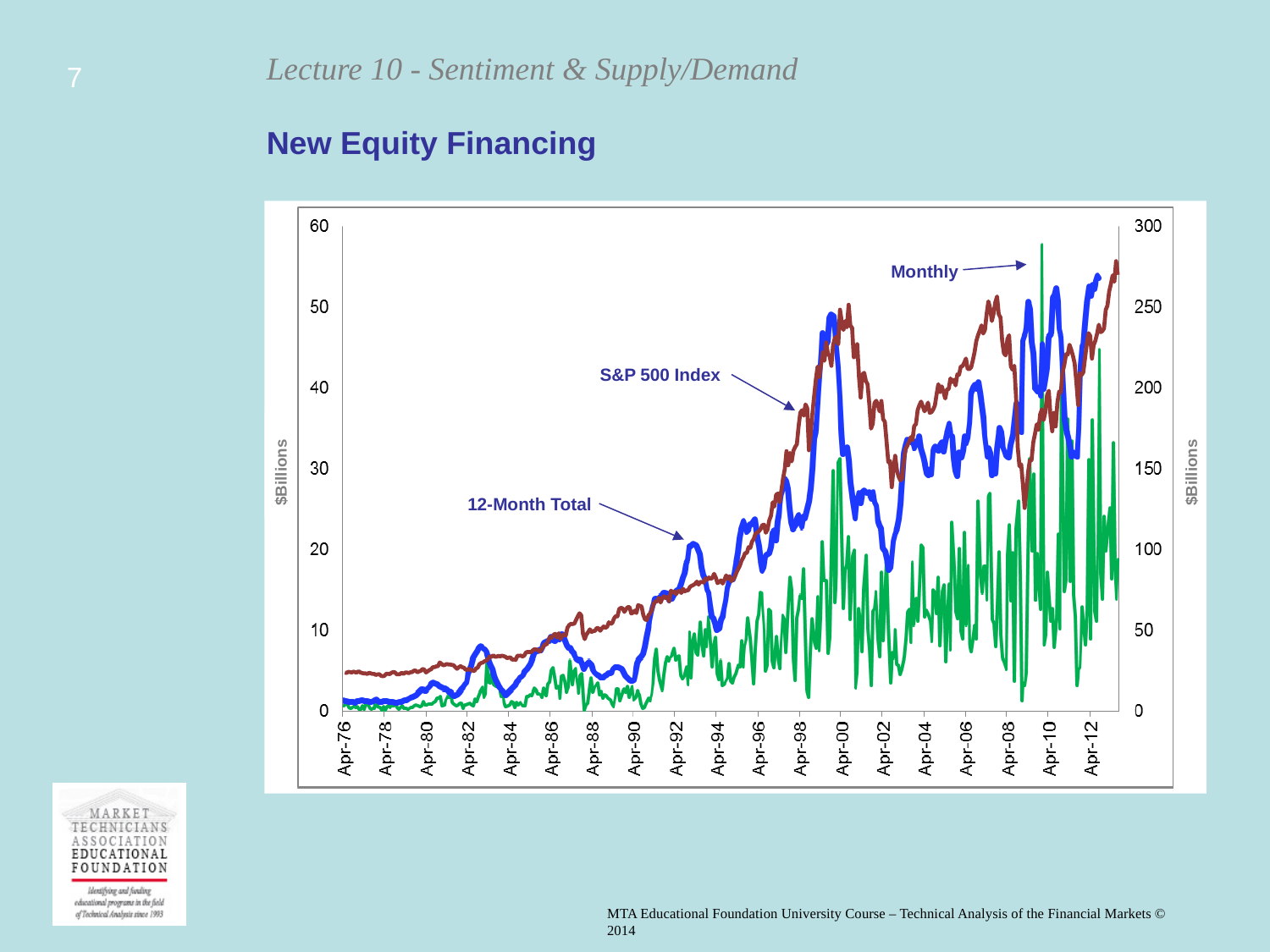
What is the title of the chart? New Equity Financing Does the 12-Month Total line generally rise or fall from Apr-76 to Apr-12? Rise What are the names of the three series labelled on the chart? Monthly, S&P 500 Index, 12-Month Total How many data series are labelled on the chart? 3 What kind of chart is shown on the slide? Line chart What is the last date label on the x axis? Apr-12 What is the maximum value shown on the left vertical axis? 60 What is the maximum value shown on the right vertical axis? 300 What is the first date label on the x axis? Apr-76 Does the S&P 500 Index line generally rise or fall from Apr-76 to Apr-12? Rise What unit label is shown on both vertical axes? $Billions How many date labels are shown on the x axis? 19